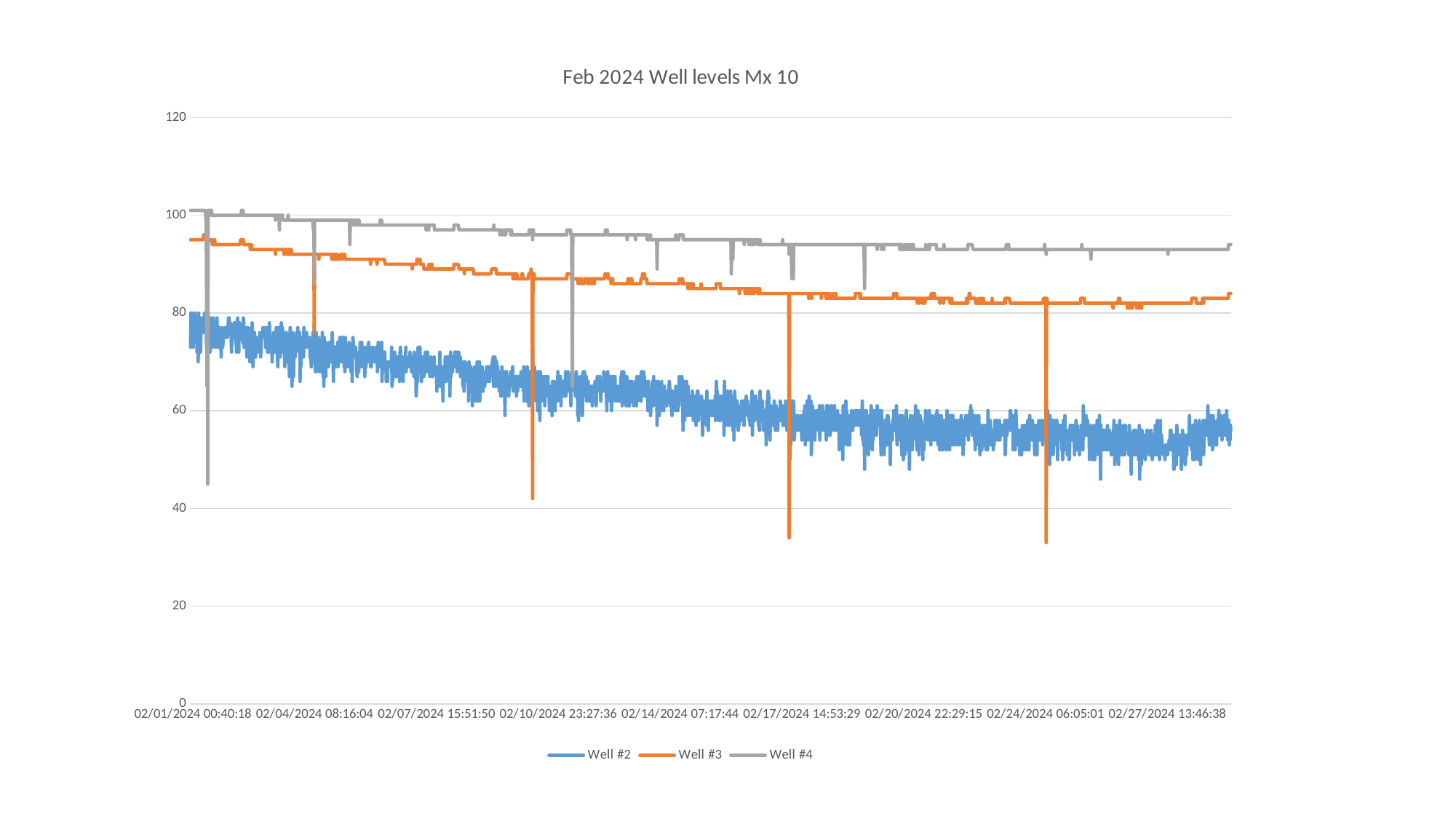
Which colour is used for the Well #3 series? orange What is the title of the chart? Feb 2024 Well levels Mx 10 Do the values for Well #3 rise or fall along the x axis? fall Which series is higher, Well #4 or Well #2? Well #4 How many series does the legend list? 3 What kind of chart is shown on the slide? line chart Which series has the highest values across the chart? Well #4 Which series has the lowest values across the chart? Well #2 Do the values for Well #2 rise or fall over the course of February? fall Is the value for Well #3 at the start of the month greater or less than 80? greater Is the value for Well #2 at the start of the month greater or less than 60? greater Is the value for Well #4 at the end of the month greater or less than 100? less